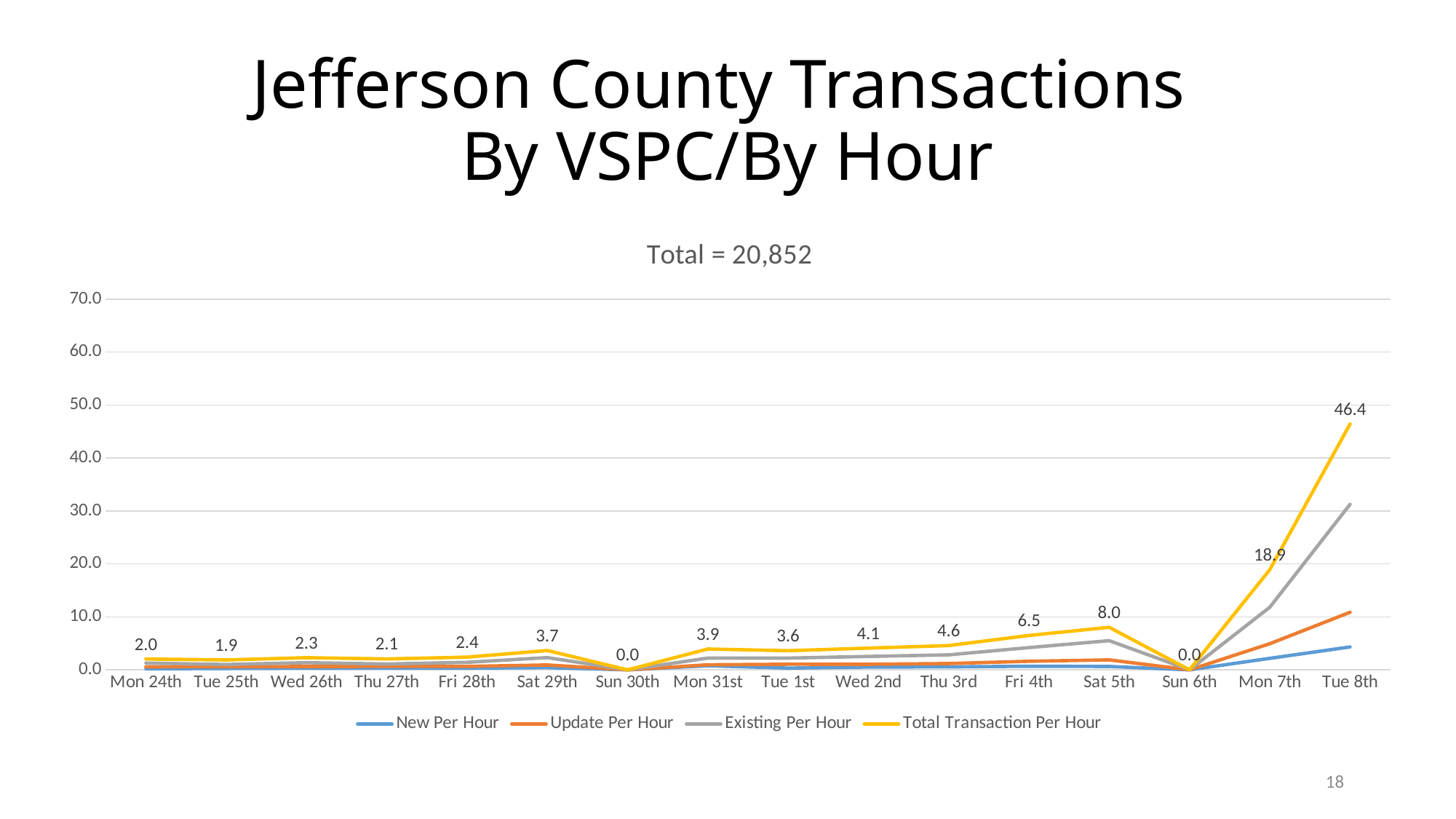
What is the Total Transaction Per Hour value for Sat 5th? 8.0 Which is larger, the Total Transaction Per Hour value for Fri 4th or for Sat 29th? Fri 4th Which series is drawn in yellow? Total Transaction Per Hour What is the Total Transaction Per Hour value for Tue 8th? 46.4 How many series does the legend list? 4 Is the Existing Per Hour value for Tue 8th greater or less than 20.0? greater How many dates are shown along the x axis? 16 On which date is the Total Transaction Per Hour value highest? Tue 8th What total is stated in the subtitle above the chart? Total = 20,852 What is the Total Transaction Per Hour value for Mon 7th? 18.9 What is the difference between the Total Transaction Per Hour values for Tue 8th and Mon 7th? 27.5 What type of chart is shown on the slide? line chart